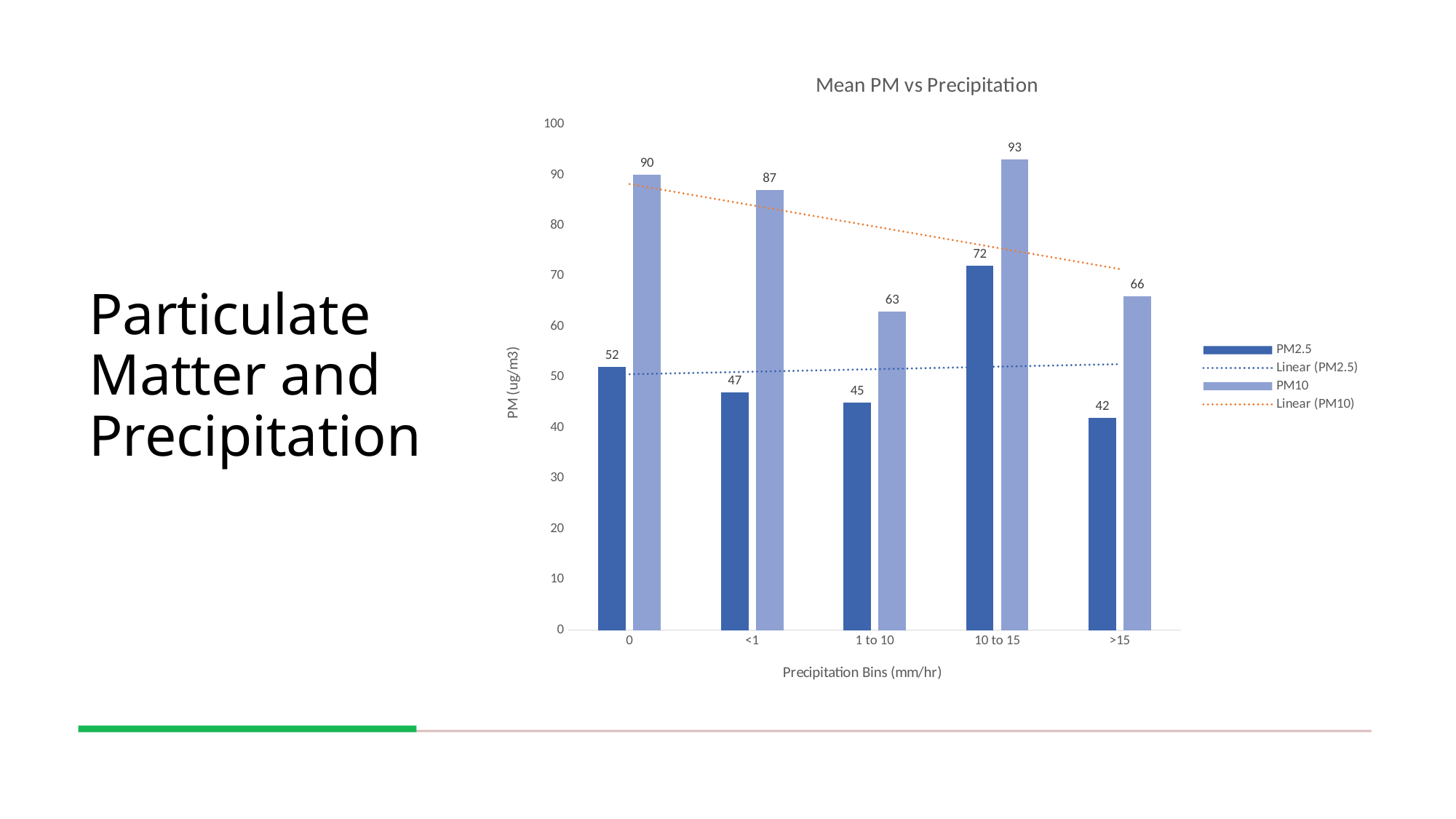
What is the PM10 value for the >15 precipitation bin? 66 What is the PM2.5 value for the 0 precipitation bin? 52 Which precipitation bin has the lowest PM2.5 value? >15 Which is larger, the PM2.5 value for <1 or the PM2.5 value for 10 to 15? 10 to 15 What is the PM10 value for the 10 to 15 precipitation bin? 93 How many precipitation bins are shown on the x axis? 5 What kind of chart is shown on the slide? Bar chart What is the label of the y axis? PM (ug/m3) What is the difference between the PM10 and PM2.5 values for the 1 to 10 precipitation bin? 18 Which precipitation bin has the highest PM10 value? 10 to 15 How many entries does the legend list? 4 What is the title of the chart? Mean PM vs Precipitation